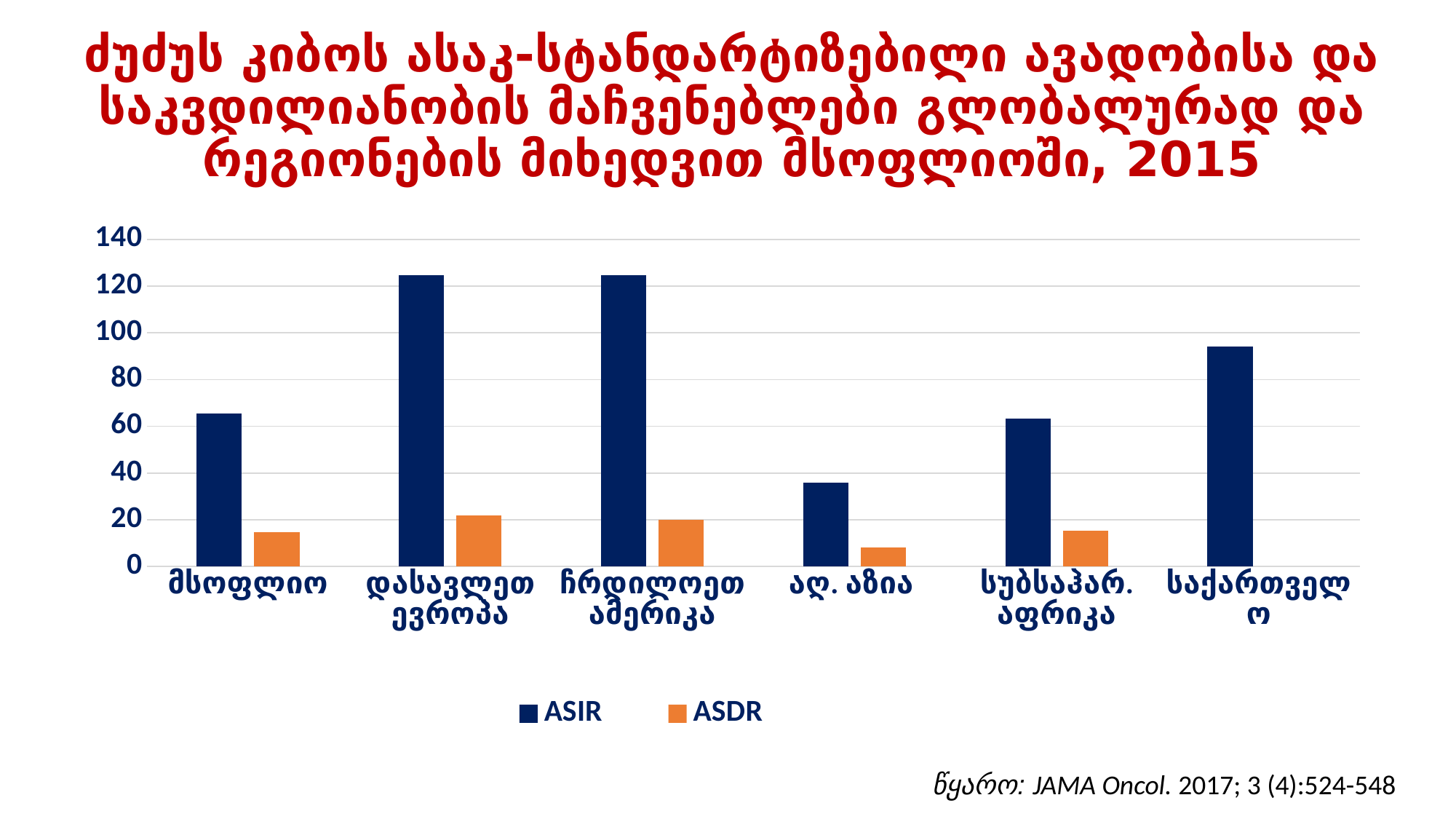
Is the ASDR value for სუბსაჰარ. აფრიკა greater or less than 20? less How many categories are shown on the x axis? 6 Is the ASIR value for მსოფლიო greater or less than 60? greater Which is larger, the ASIR value for საქართველო or the ASIR value for მსოფლიო? საქართველო Is the ASIR value for საქართველო greater or less than 100? less Which category has the lowest ASIR value? აღ. აზია What are the two series names listed in the legend? ASIR and ASDR How many series does the legend list? 2 What kind of chart is shown on the slide? bar chart Which is larger, the ASIR value for აღ. აზია or the ASIR value for სუბსაჰარ. აფრიკა? სუბსაჰარ. აფრიკა